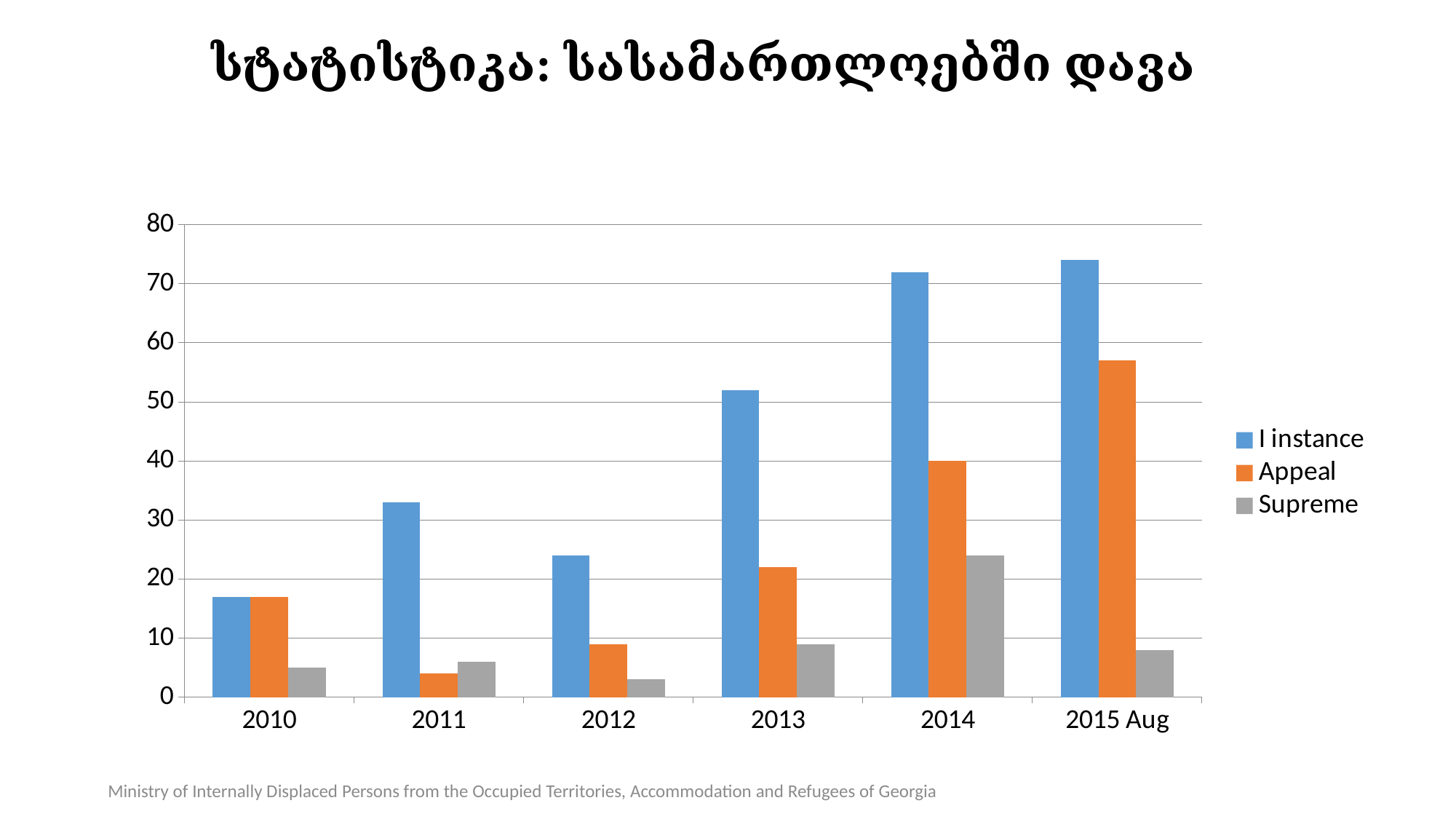
Is the Supreme value for 2014 greater or less than 20? greater How many year categories are shown on the x axis? 6 How many series does the legend list? 3 Which colour represents the Appeal series in the legend? orange What kind of chart is shown on the slide? bar chart Is the Appeal value for 2015 Aug greater or less than 50? greater Which is larger: the I instance value for 2013 or the Appeal value for 2014? I instance for 2013 Which year has the lowest I instance value? 2010 Which year has the highest Appeal value? 2015 Aug Is the I instance value for 2012 greater or less than 30? less Which year has the highest Supreme value? 2014 Which year has the lowest Appeal value? 2011